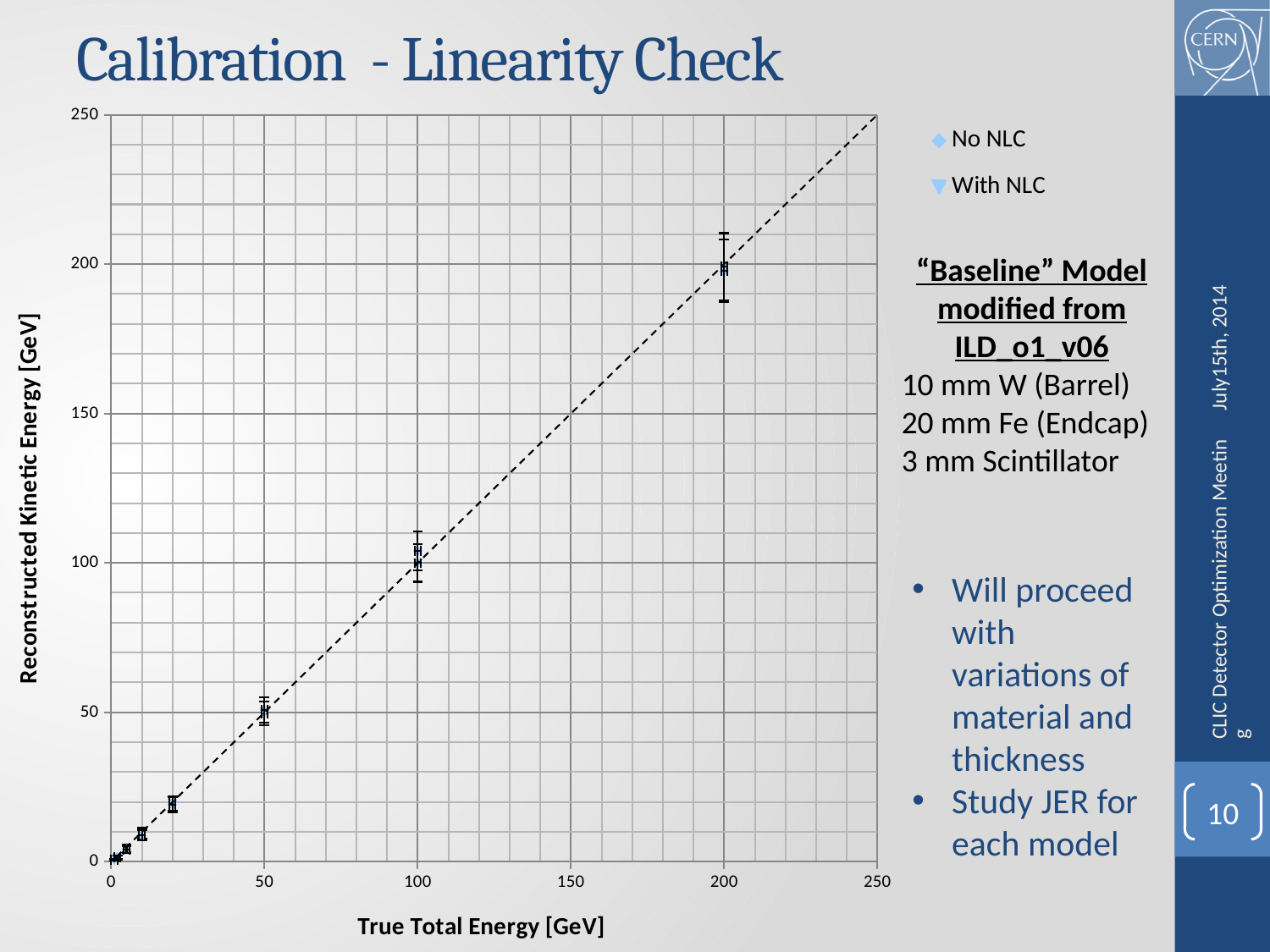
Is the reconstructed kinetic energy larger at a true total energy of 100 GeV or at 50 GeV? 100 GeV Do the reconstructed kinetic energy values rise or fall as the true total energy increases along the x axis? Rise Is the reconstructed kinetic energy at a true total energy of 50 GeV greater or less than 100? less What is the title of the chart's x axis? True Total Energy [GeV] Is the reconstructed kinetic energy at a true total energy of 100 GeV greater or less than 50? greater How many series does the chart legend list? 2 What kind of chart is shown on the slide? Scatter chart Is the reconstructed kinetic energy at a true total energy of 200 GeV greater or less than 250? less What are the two series named in the chart legend? No NLC and With NLC Which true total energy value has the highest reconstructed kinetic energy on the chart? 200 What is the maximum value shown on the chart's y axis? 250